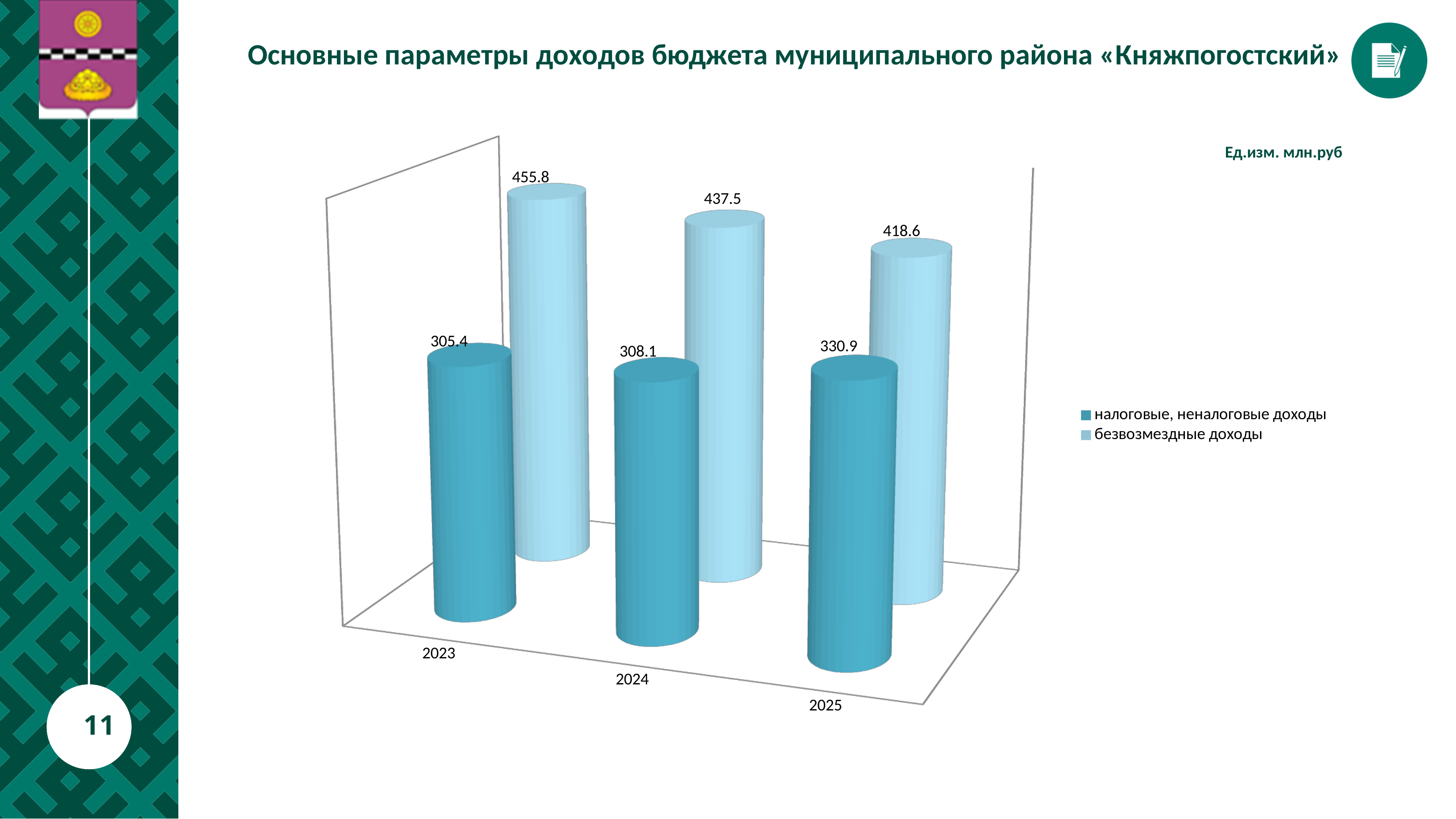
What is the value for безвозмездные доходы in 2024? 437.5 What is the difference between безвозмездные доходы in 2023 and in 2025? 37.2 How many years are shown on the x axis? 3 What is the value for налоговые, неналоговые доходы in 2023? 305.4 How many series does the legend list? 2 In which year is налоговые, неналоговые доходы lowest? 2023 In which year is безвозмездные доходы highest? 2023 What is the difference between безвозмездные доходы and налоговые, неналоговые доходы in 2025? 87.7 What is the value for безвозмездные доходы in 2025? 418.6 Do the values for безвозмездные доходы rise or fall from 2023 to 2025? fall Which is larger in 2024: налоговые, неналоговые доходы or безвозмездные доходы? безвозмездные доходы What kind of chart is shown on the slide? bar chart